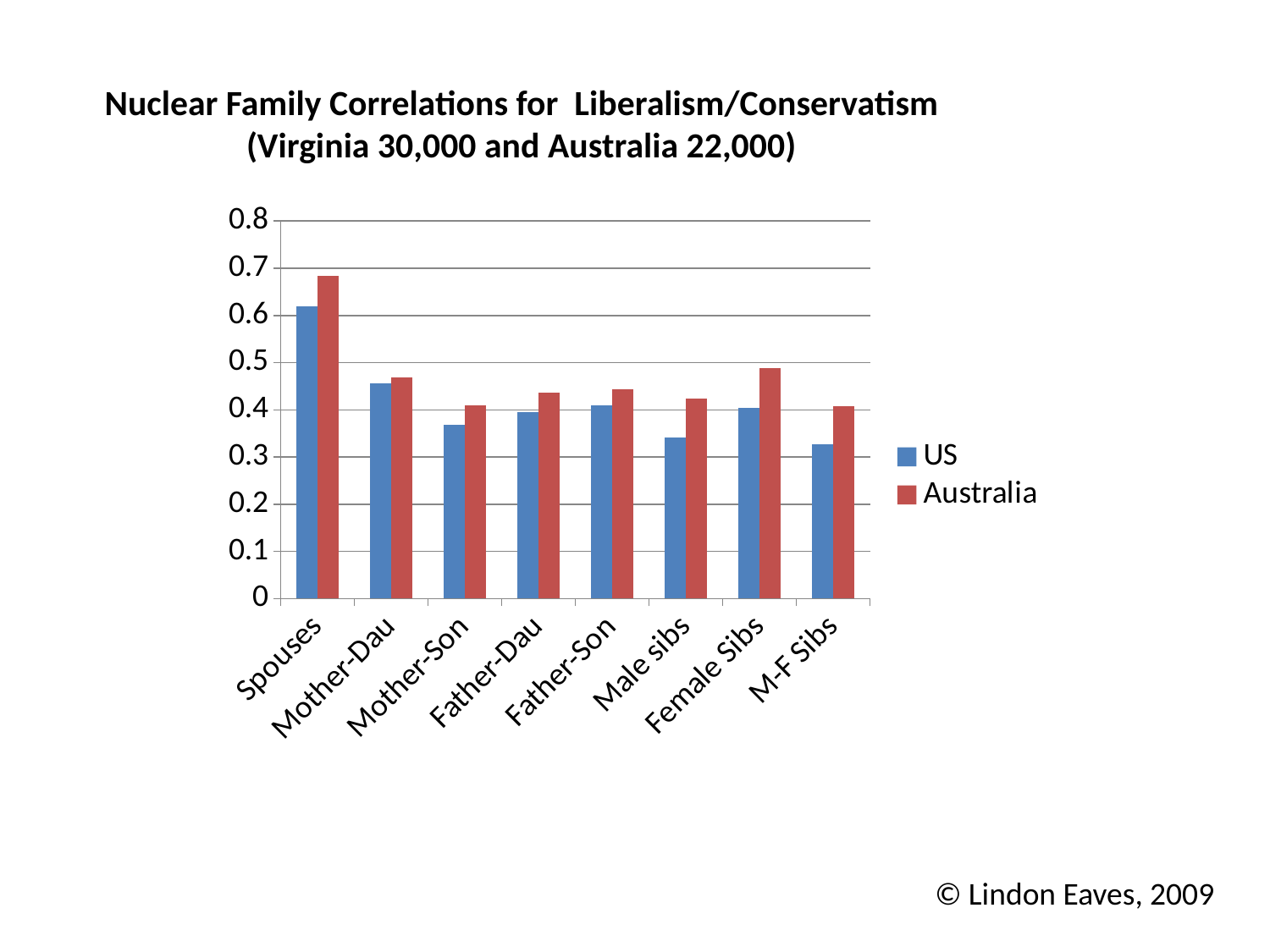
For Male sibs, which series has the larger value, US or Australia? Australia Which category has the highest US correlation? Spouses Is the Australia value for Spouses greater or less than 0.6? greater What kind of chart is shown on the slide? bar chart How many series does the legend list? 2 Is the US value for M-F Sibs greater or less than 0.4? less Is the US value for Male sibs greater or less than 0.4? less Which category has the highest Australia correlation? Spouses For Spouses, which series has the larger value, US or Australia? Australia How many categories are shown on the x axis of the chart? 8 What are the two series named in the legend? US and Australia